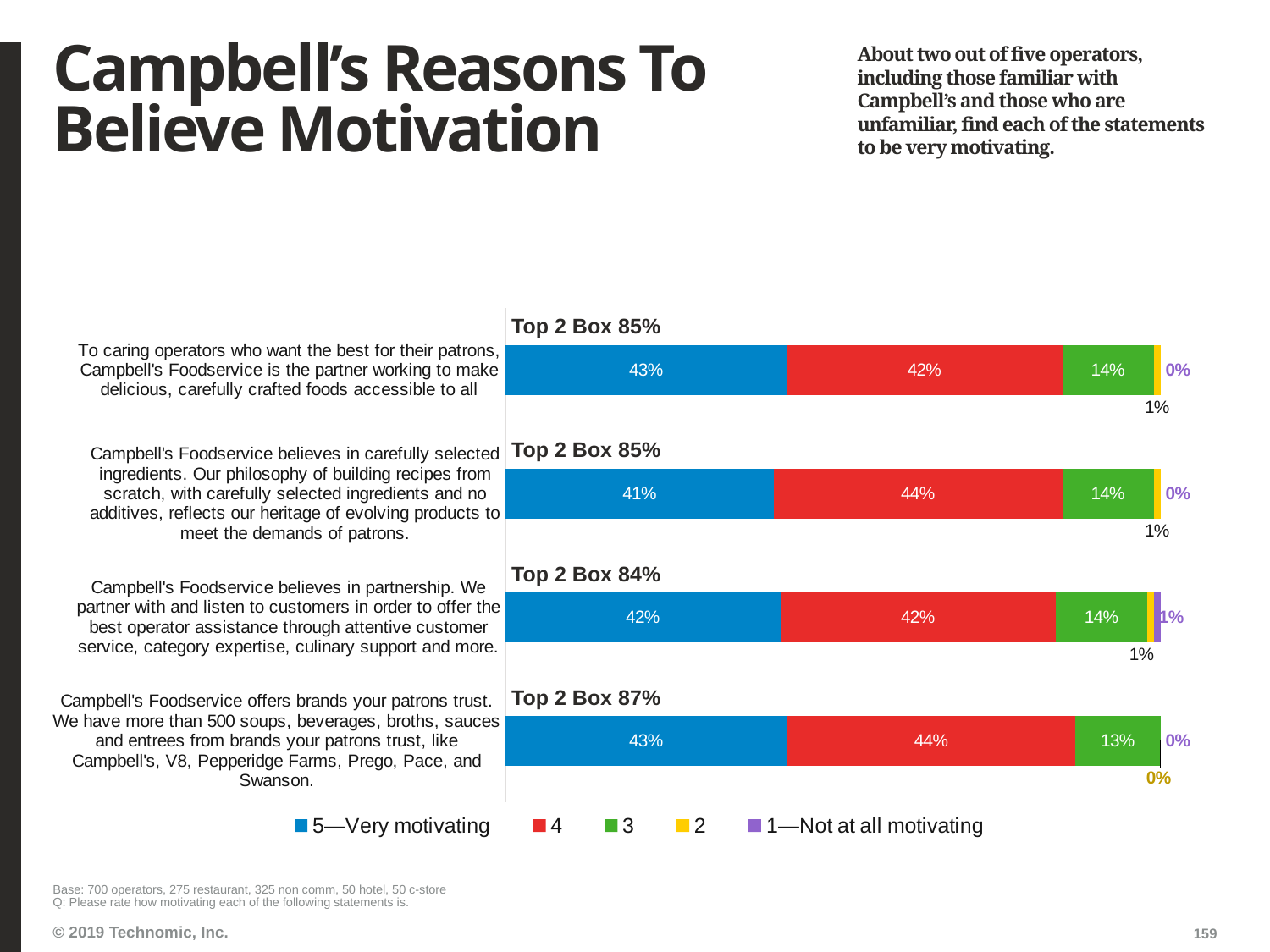
Which statement has the lowest Top 2 Box score? Campbell's Foodservice believes in partnership What percentage of operators rated the statement "Campbell's Foodservice offers brands your patrons trust" as 5—Very motivating? 43% How many statements are shown in the chart? 4 For the statement "Campbell's Foodservice believes in partnership", which is larger: the share rating it 5—Very motivating or the share rating it 3? 5—Very motivating What is the difference between the Top 2 Box score for "Campbell's Foodservice offers brands your patrons trust" and the Top 2 Box score for "Campbell's Foodservice believes in partnership"? 3% Which statement has the highest Top 2 Box score? Campbell's Foodservice offers brands your patrons trust How many series does the legend list? 5 Which statement has the lowest share of 5—Very motivating ratings? Campbell's Foodservice believes in carefully selected ingredients What type of chart is shown on the slide? Stacked bar chart What is the Top 2 Box score for the statement "Campbell's Foodservice believes in partnership"? 84% What percentage of operators rated the statement "Campbell's Foodservice believes in partnership" as 1—Not at all motivating? 1% What percentage of operators gave a rating of 4 to the statement "Campbell's Foodservice believes in carefully selected ingredients"? 44%